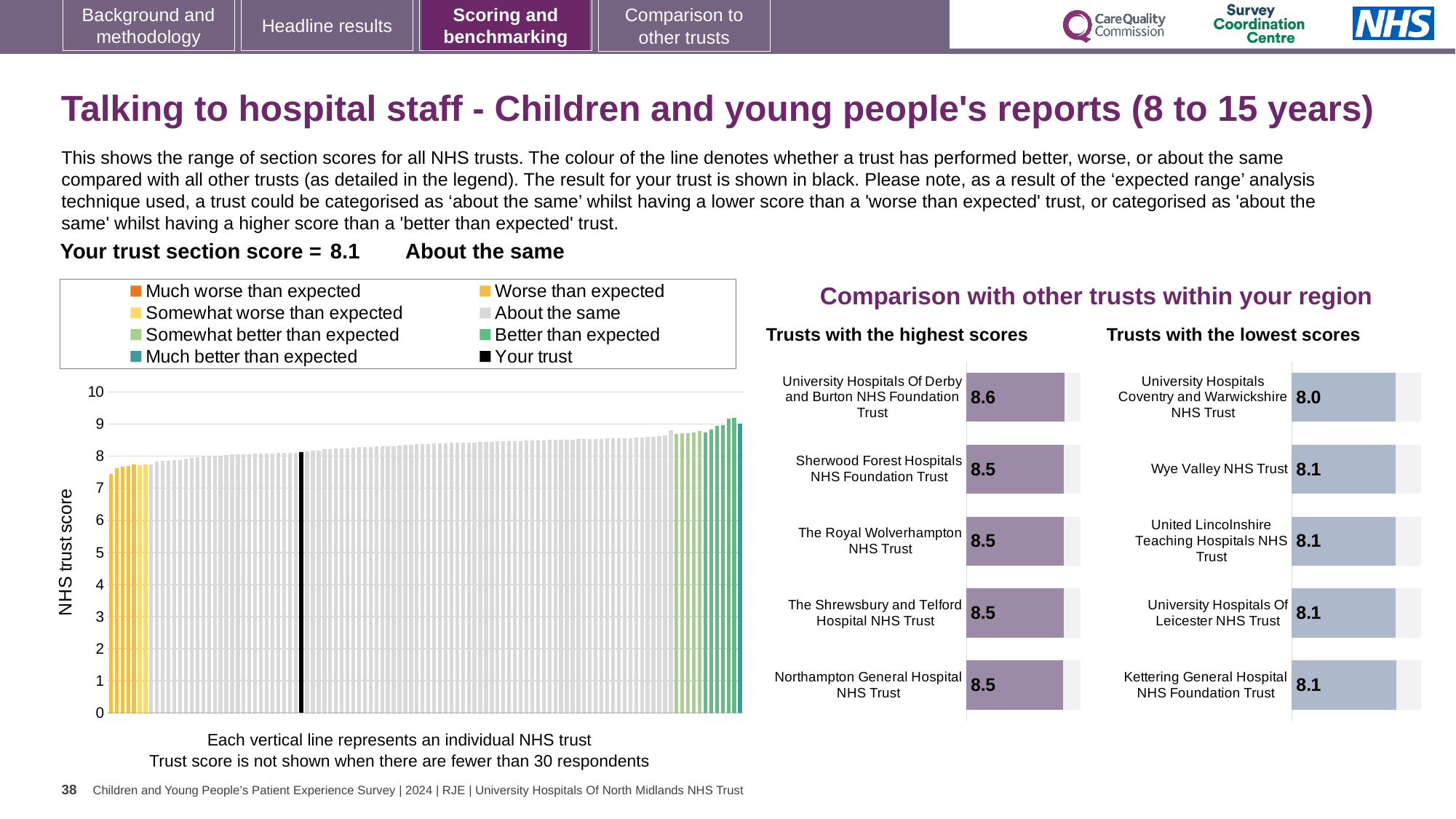
In the 'Trusts with the lowest scores' chart, which trust has the lowest score? University Hospitals Coventry and Warwickshire NHS Trust What kind of chart is the main chart on the left showing NHS trust scores? Bar chart In the 'Trusts with the lowest scores' chart, what is the score for Kettering General Hospital NHS Foundation Trust? 8.1 In the main chart on the left, is the value for the lowest-scoring trust (the leftmost bar) greater or less than 8? less In the 'Trusts with the lowest scores' chart, which is larger: the score for Wye Valley NHS Trust or the score for University Hospitals Coventry and Warwickshire NHS Trust? Wye Valley NHS Trust In the main chart on the left, how many entries does the legend list? 8 In the 'Trusts with the highest scores' chart, what is the difference between the scores of University Hospitals Of Derby and Burton NHS Foundation Trust and Sherwood Forest Hospitals NHS Foundation Trust? 0.1 In the 'Trusts with the highest scores' chart, what is the score for University Hospitals Of Derby and Burton NHS Foundation Trust? 8.6 In the 'Trusts with the lowest scores' chart, what is the score for University Hospitals Coventry and Warwickshire NHS Trust? 8.0 In the 'Trusts with the highest scores' chart, what is the score for Northampton General Hospital NHS Trust? 8.5 In the 'Trusts with the highest scores' chart, which trust has the highest score? University Hospitals Of Derby and Burton NHS Foundation Trust In the 'Trusts with the highest scores' chart, how many trusts are shown? 5